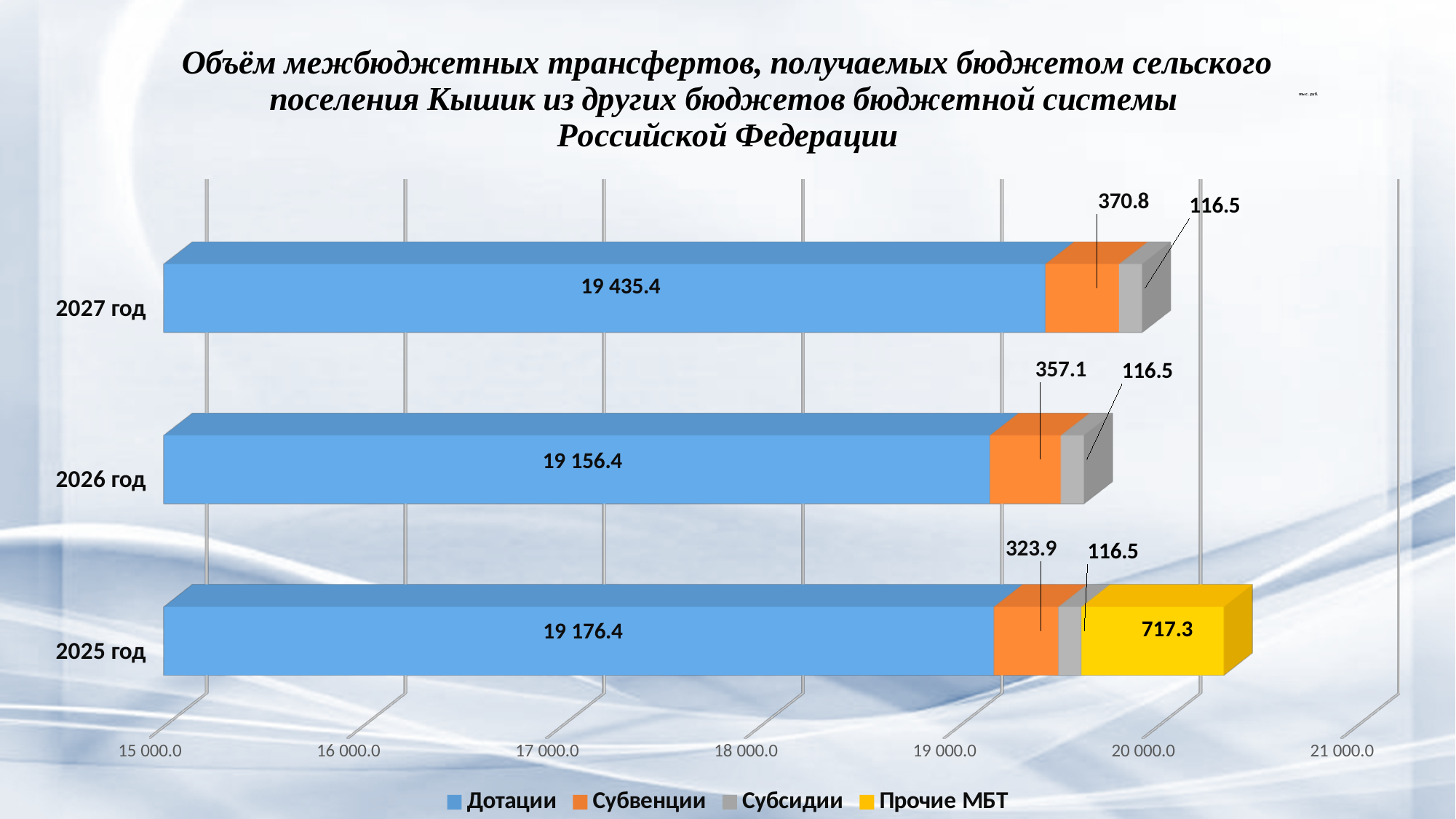
Which year has the lowest value of Субвенции? 2025 год What is the value of Субсидии for 2025 год? 116.5 Which year has the highest value of Дотации? 2027 год Which is larger: Субвенции for 2027 год or Субвенции for 2025 год? Субвенции for 2027 год What type of chart is shown on the slide? Stacked bar chart How many years (categories) are shown on the chart? 3 What is the total of the stacked bar for 2027 год? 19 922.7 What is the value of Субвенции for 2026 год? 357.1 What is the difference between the Дотации values for 2027 год and 2026 год? 279.0 How many series does the legend list? 4 What is the value of Дотации for 2027 год? 19 435.4 What is the value of Прочие МБТ for 2025 год? 717.3